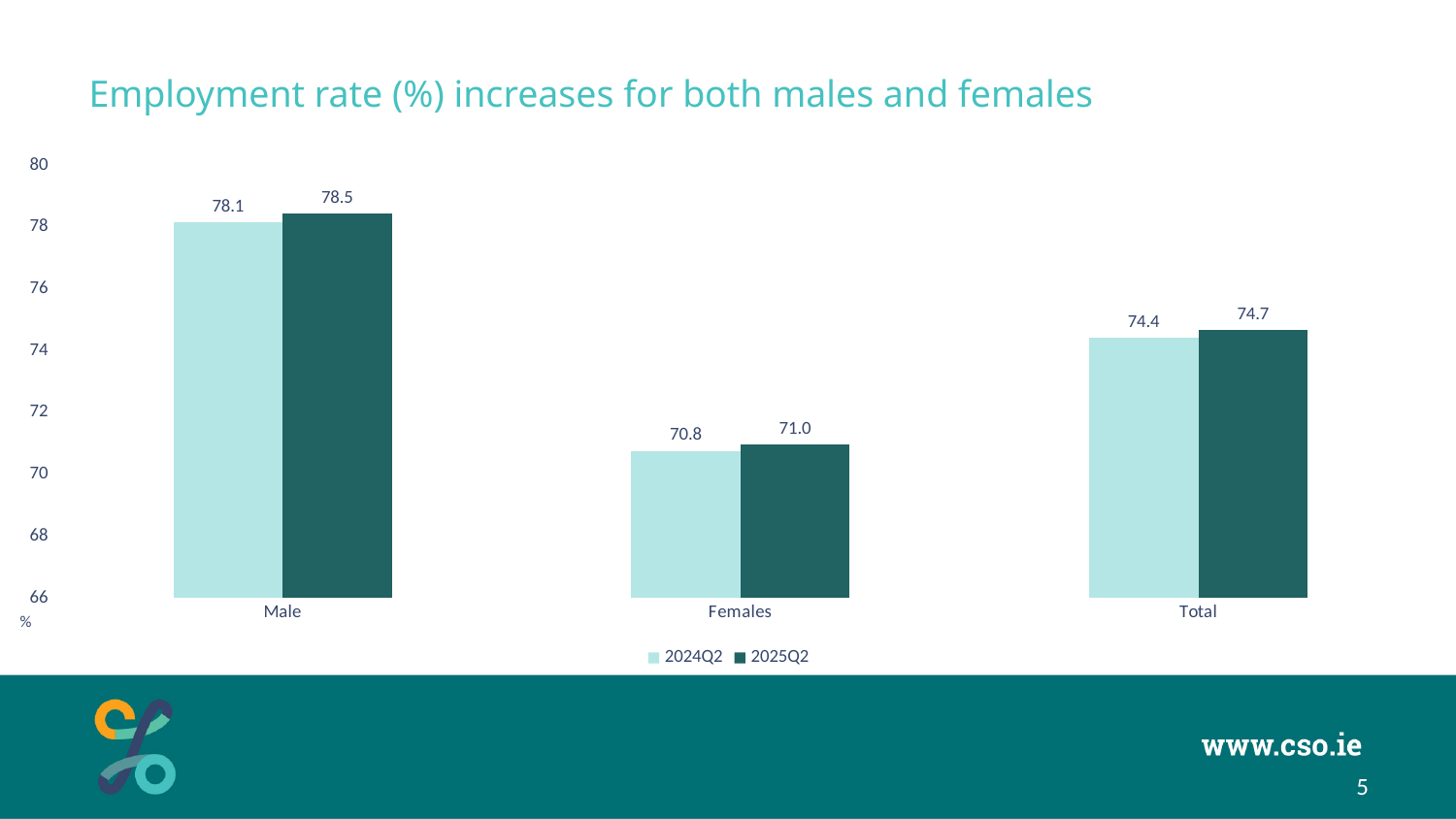
How many categories are shown on the x axis? 3 Which category has the highest employment rate in 2025Q2? Male Is the Male employment rate in 2024Q2 greater or less than the Total employment rate in 2024Q2? greater What is the difference between the Male and Female employment rates in 2025Q2? 7.5 What is the Total employment rate in 2025Q2? 74.7 Which category has the lowest employment rate in 2024Q2? Females What is the employment rate for Females in 2024Q2? 70.8 What kind of chart is shown on the slide? Bar chart What is the employment rate for Males in 2025Q2? 78.5 By how much did the Female employment rate change from 2024Q2 to 2025Q2? 0.2 Is the Female employment rate in 2025Q2 greater or less than 72? less How many series does the legend list? 2